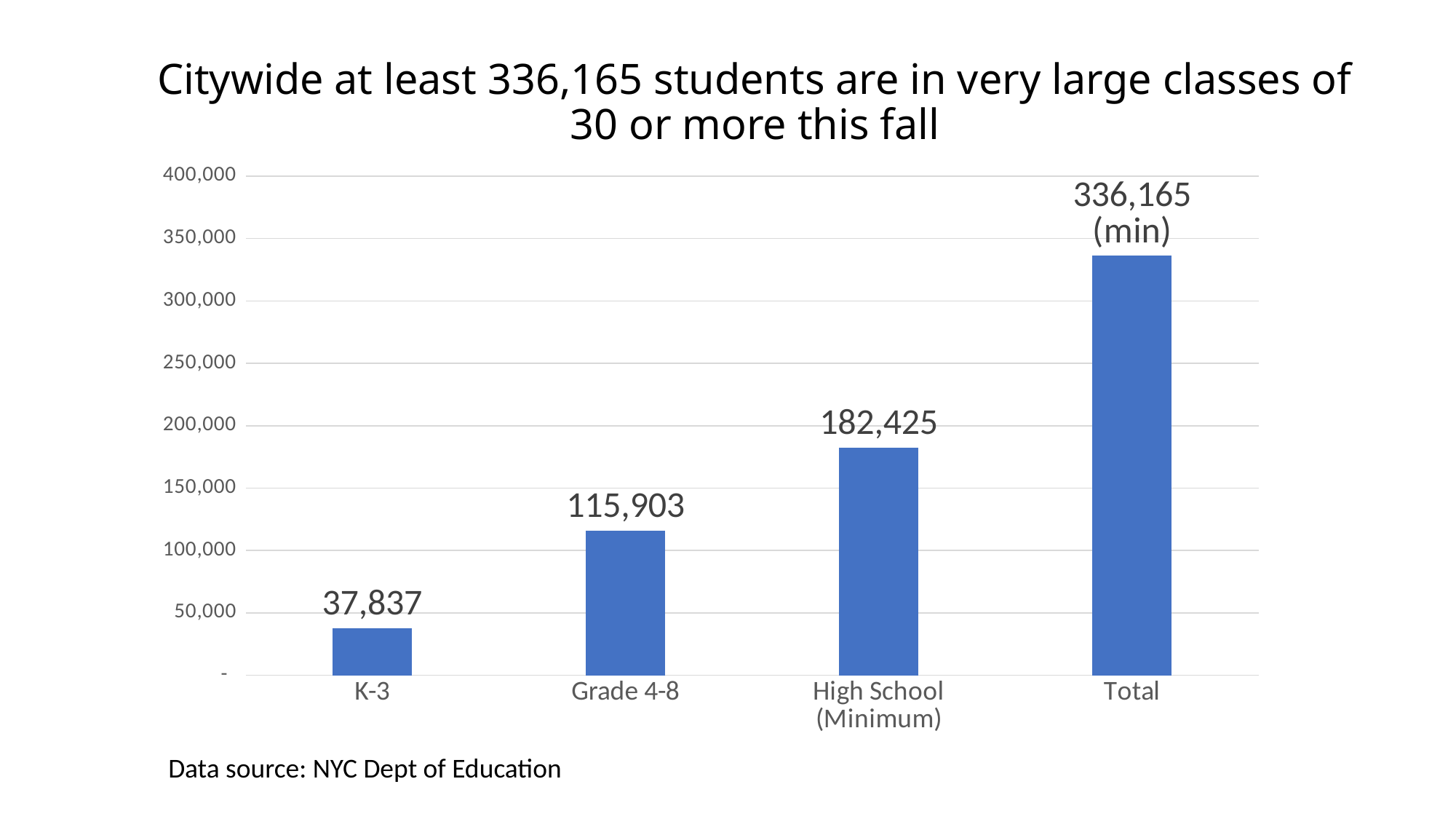
What is the difference between the values for High School (Minimum) and Grade 4-8? 66,522 Which is larger, the value for Grade 4-8 or the value for High School (Minimum)? High School (Minimum) What is the value for Total? 336,165 What is the value for High School (Minimum)? 182,425 Which category has the highest value? Total Is the value for Grade 4-8 greater or less than 100,000? greater What is the value for Grade 4-8? 115,903 What is the difference between the values for Grade 4-8 and K-3? 78,066 Which category has the lowest value? K-3 What is the value for K-3? 37,837 How many categories are shown on the x axis? 4 What kind of chart is shown on the slide? bar chart